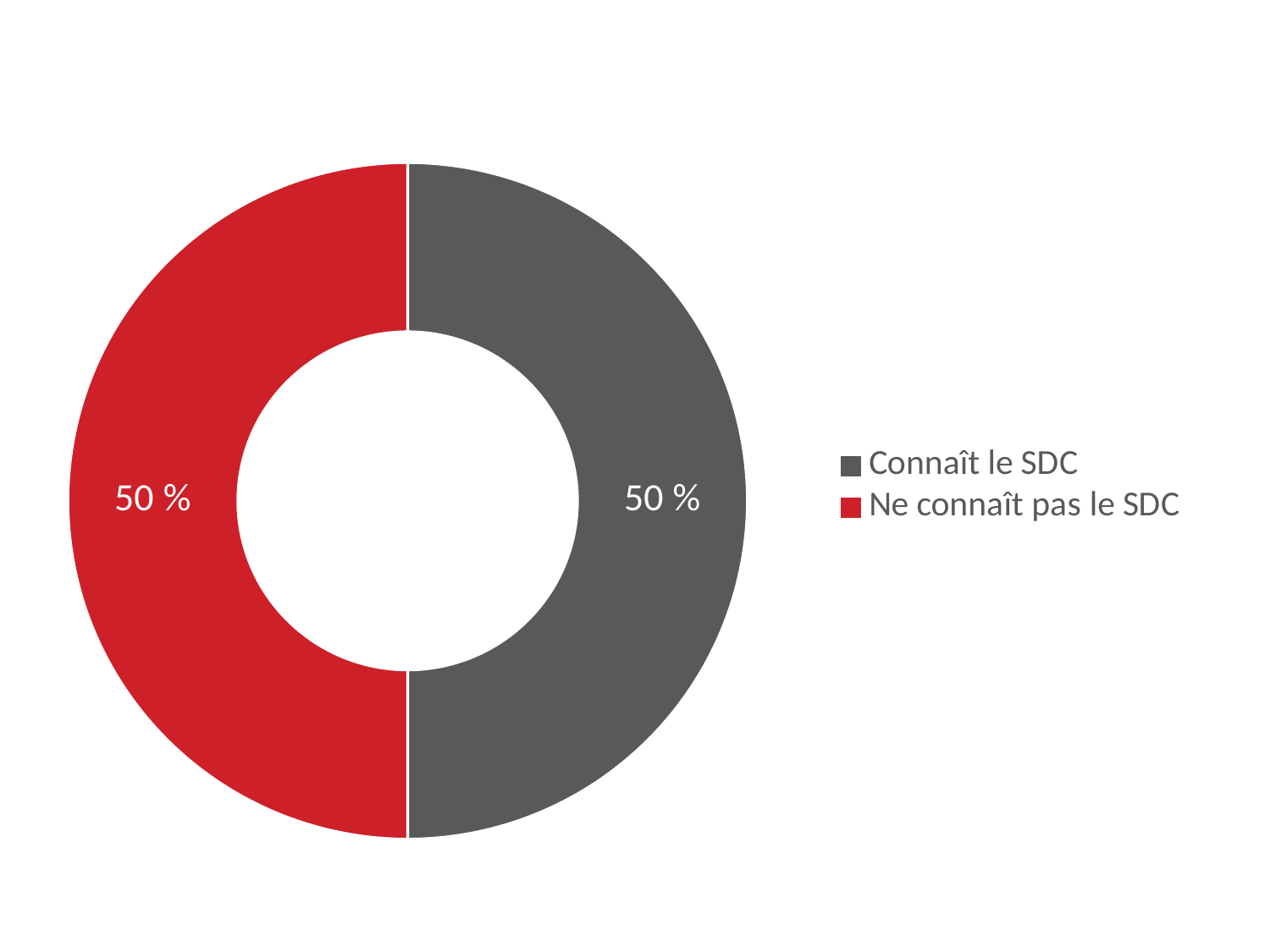
Which colour represents "Connaît le SDC"? Grey What share of the chart does "Connaît le SDC" represent? 50 % How many categories does the chart show? 2 What share of the chart does "Ne connaît pas le SDC" represent? 50 % What is the total of the two slices shown? 100 % What is the difference between the shares of "Connaît le SDC" and "Ne connaît pas le SDC"? 0 % Which colour represents "Ne connaît pas le SDC"? Red How many entries does the legend list? 2 Is the share for "Connaît le SDC" greater or less than 25 %? greater What kind of chart is shown on the slide? Doughnut (pie) chart